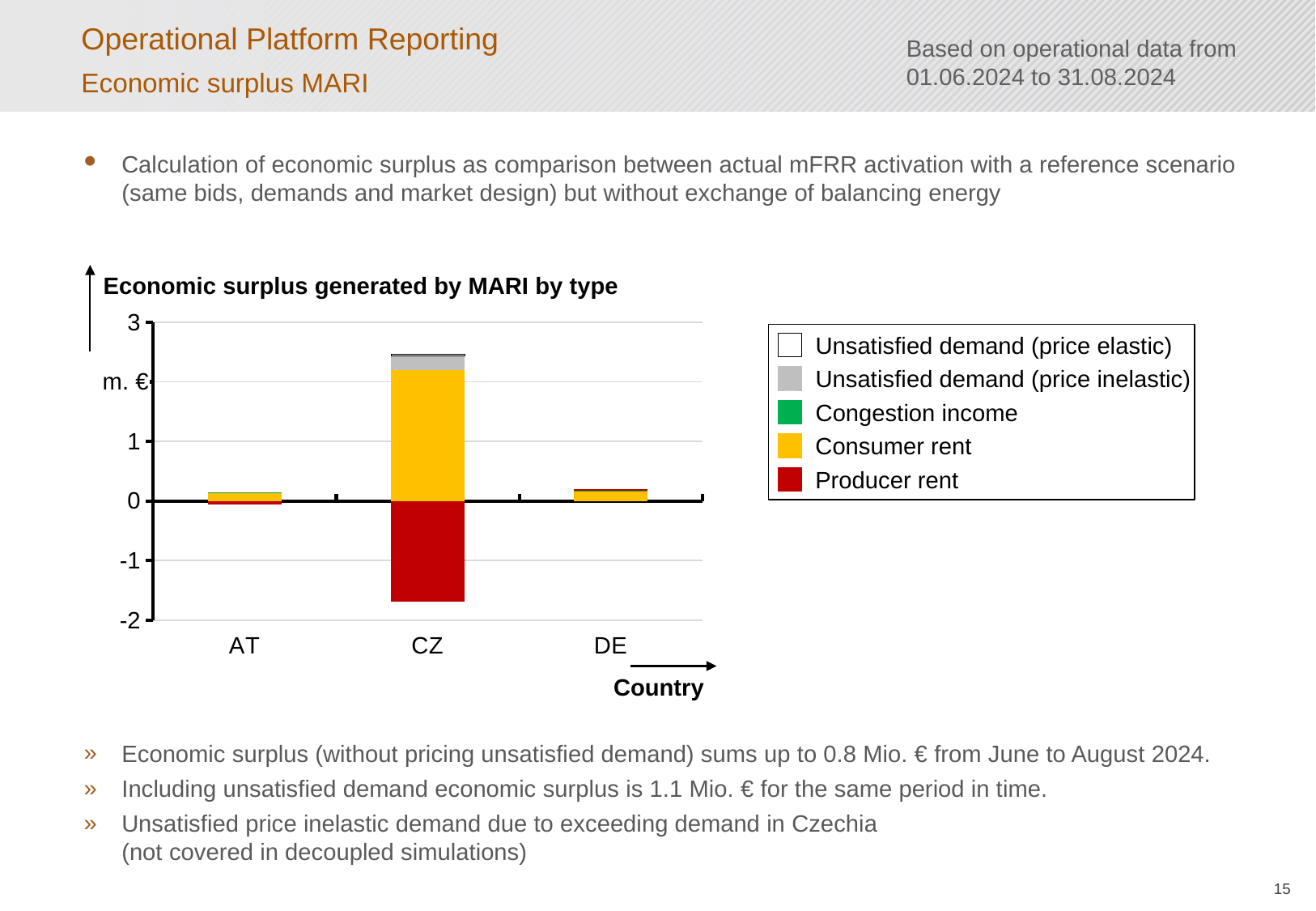
Is the Consumer rent value for DE greater or less than 1? less Which country has a larger Consumer rent, CZ or AT? CZ Which country shows a visible Unsatisfied demand (price inelastic) segment in the chart? CZ Is the Producer rent value for CZ greater or less than -1? less What is the label of the x axis of the chart? Country Is the Consumer rent value for CZ greater or less than 1? greater How many countries are shown on the x axis of the chart? 3 How many series does the chart legend list? 5 What is the title of the chart? Economic surplus generated by MARI by type Which country has the most negative Producer rent in the chart? CZ Which country has the largest Consumer rent in the chart? CZ What kind of chart is shown on the slide? bar chart